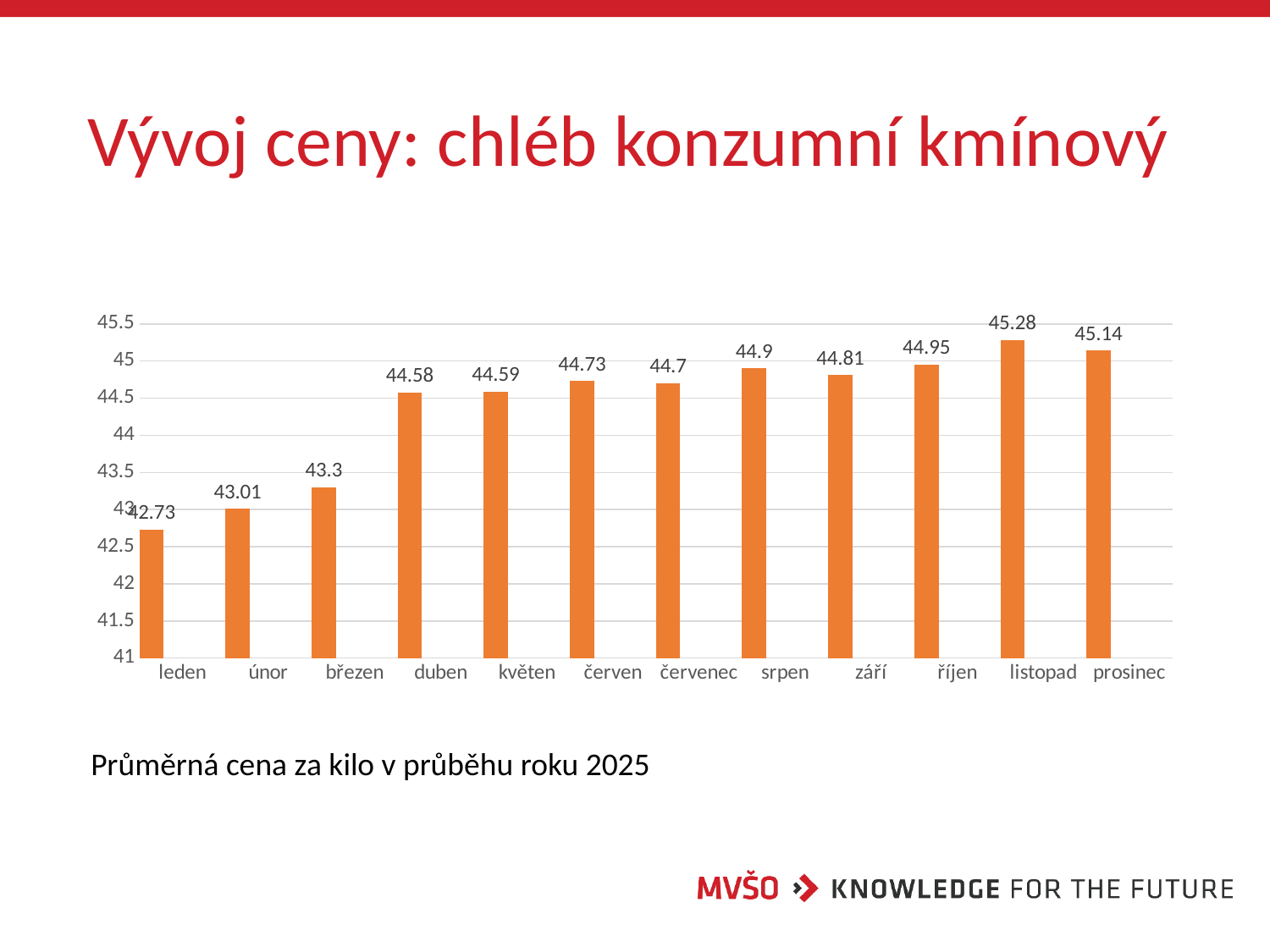
Which month has the highest value? listopad What is the value for duben? 44.58 What is the difference between the values for prosinec and leden? 2.41 Which is larger, the value for srpen or the value for září? srpen What kind of chart is shown on the slide? bar chart Is the value for březen greater or less than 44? less What is the value for leden? 42.73 What is the title of the slide containing the chart? Vývoj ceny: chléb konzumní kmínový Do the values generally rise or fall from leden to prosinec? rise How many months are shown on the x axis? 12 What is the value for listopad? 45.28 Which month has the lowest value? leden